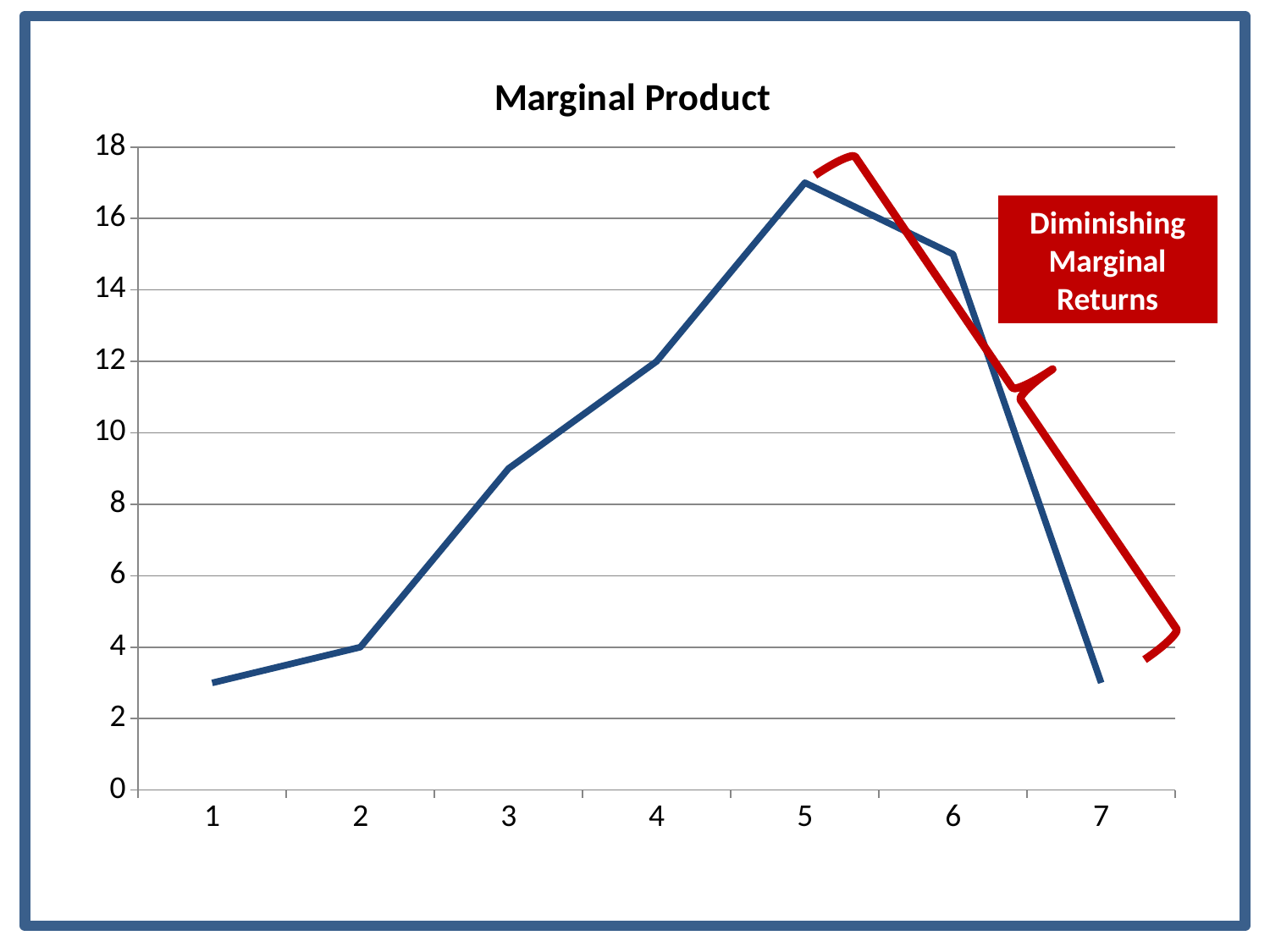
How many data points are plotted on the line? 7 Is the value at x = 7 greater or less than 4? less What is the value of marginal product at x = 4? 12 Is the value at x = 3 greater or less than 8? greater Which has the larger marginal product, x = 3 or x = 6? x = 6 What is the title of the chart? Marginal Product At which x value does the marginal product reach its highest point? 5 What text appears in the red label on the chart? Diminishing Marginal Returns Does the marginal product rise or fall between x = 5 and x = 7? Fall Is the value at x = 5 greater or less than 16? greater What type of chart is shown on the slide? Line chart What is the value of marginal product at x = 2? 4